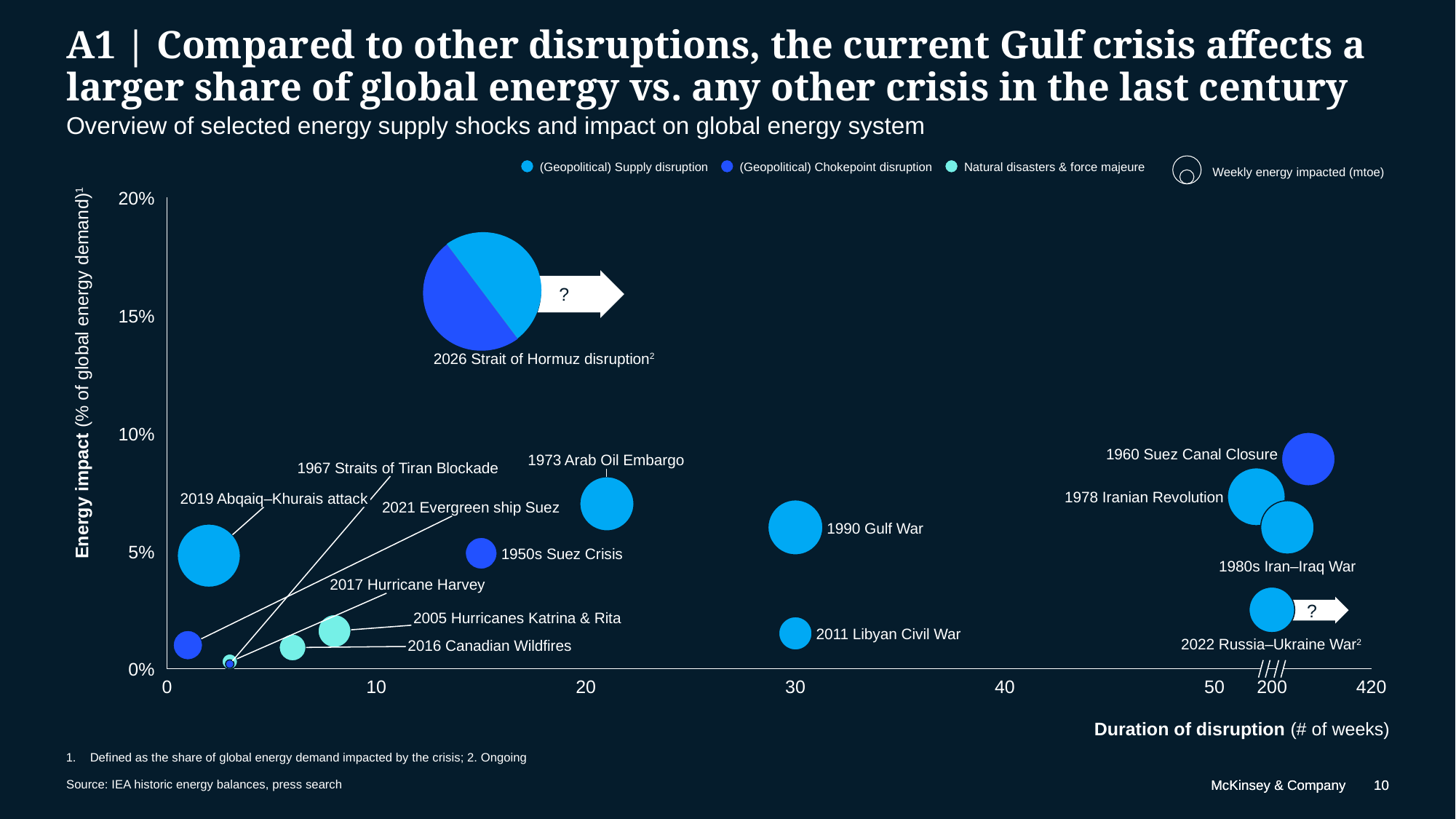
Which has the higher energy impact, the 1990 Gulf War or the 2011 Libyan Civil War? 1990 Gulf War Is the energy impact for the 2026 Strait of Hormuz disruption greater or less than 15%? greater Is the energy impact for the 2011 Libyan Civil War greater or less than 5%? less Is the energy impact for the 1960 Suez Canal Closure greater or less than 5%? greater How many series does the legend list? 3 What kind of chart is shown on the slide? Bubble chart Which has the higher energy impact, the 2026 Strait of Hormuz disruption or the 1960 Suez Canal Closure? 2026 Strait of Hormuz disruption What does the size of each bubble represent, according to the legend? Weekly energy impacted (mtoe) Which event has the highest energy impact (% of global energy demand)? 2026 Strait of Hormuz disruption What is the label of the x axis? Duration of disruption (# of weeks)